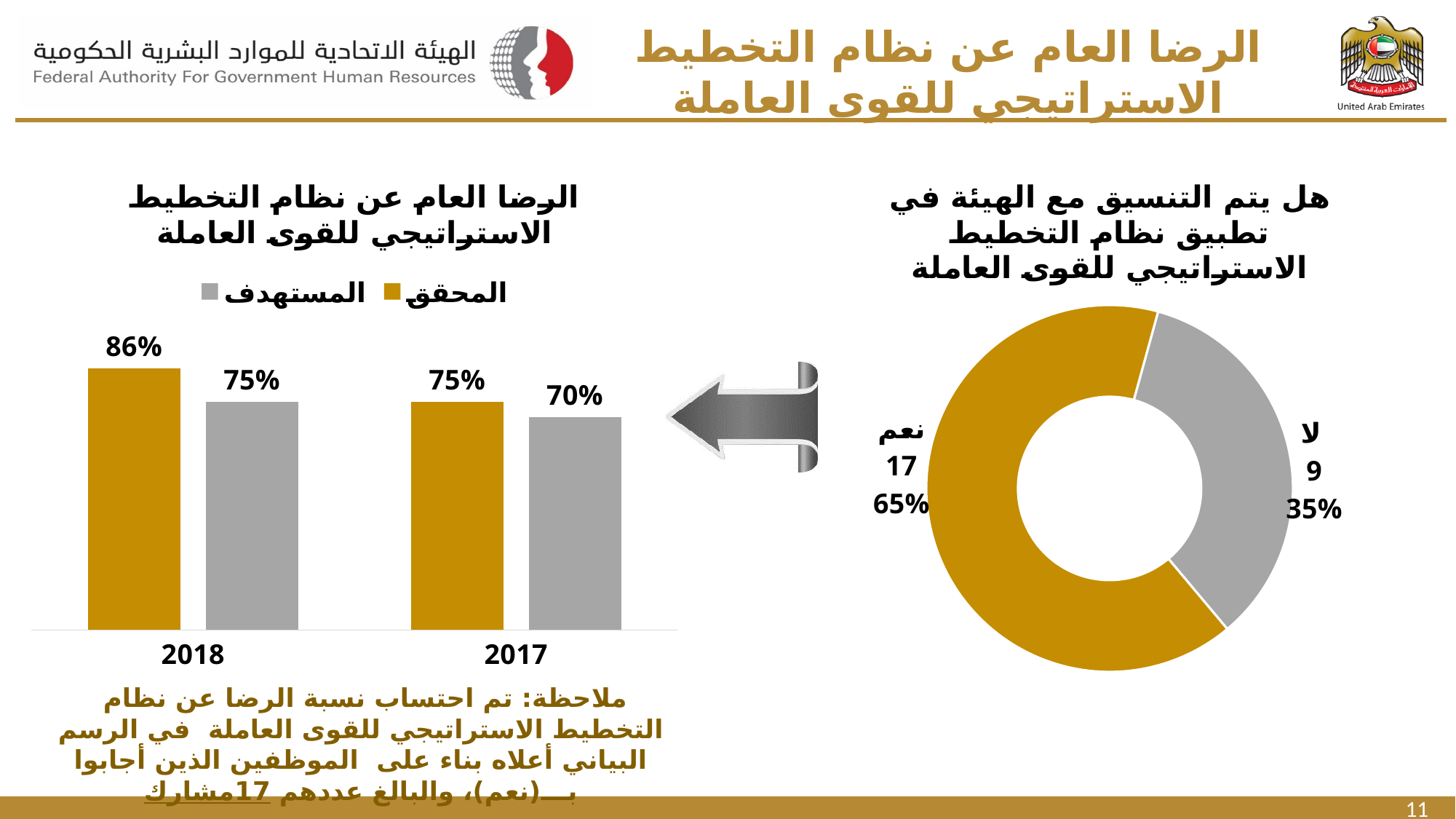
In the bar chart on the left, how many series does the legend list? 2 In the doughnut chart on the right, what percentage share does نعم have? 65% In the doughnut chart on the right, how many respondents answered لا? 9 In the bar chart on the left, what is the value of المحقق for 2018? 86% In the doughnut chart on the right, what is the total number of respondents across نعم and لا? 26 In the bar chart on the left, what is the difference between المحقق and المستهدف for 2018? 11% In the bar chart on the left, how many years are shown on the x axis? 2 In the doughnut chart on the right, which answer has the larger share, نعم or لا? نعم In the bar chart on the left, what is the value of المحقق for 2017? 75% In the bar chart on the left, which year has the higher المحقق value, 2018 or 2017? 2018 What kind of chart is the chart on the left of the slide? Bar chart In the bar chart on the left, what is the value of المستهدف for 2017? 70%